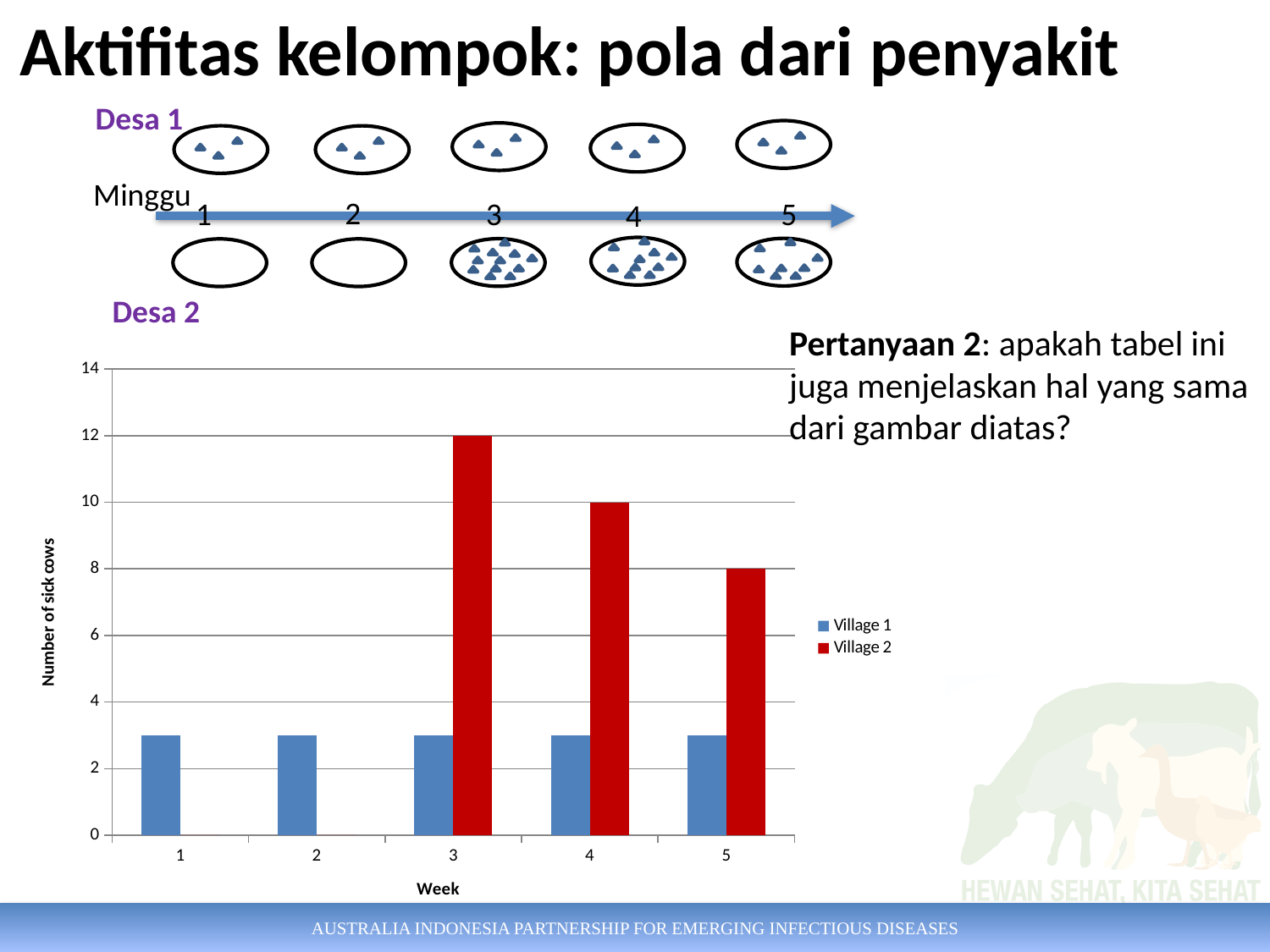
How many series does the chart legend list? 2 What is the number of sick cows for Village 2 in week 4? 10 What is the number of sick cows for Village 2 in week 3? 12 In which week is the Village 2 value highest? 3 What kind of chart is shown on the slide? bar chart What is the number of sick cows for Village 2 in week 5? 8 What is the difference between the Village 2 values in week 3 and week 5? 4 In week 3, which series has the larger value, Village 1 or Village 2? Village 2 What is the title of the y axis of the chart? Number of sick cows How many weeks are shown on the x axis of the chart? 5 Is the value for Village 1 in week 1 greater or less than 4? less Is the value for Village 1 in week 2 greater or less than 2? greater